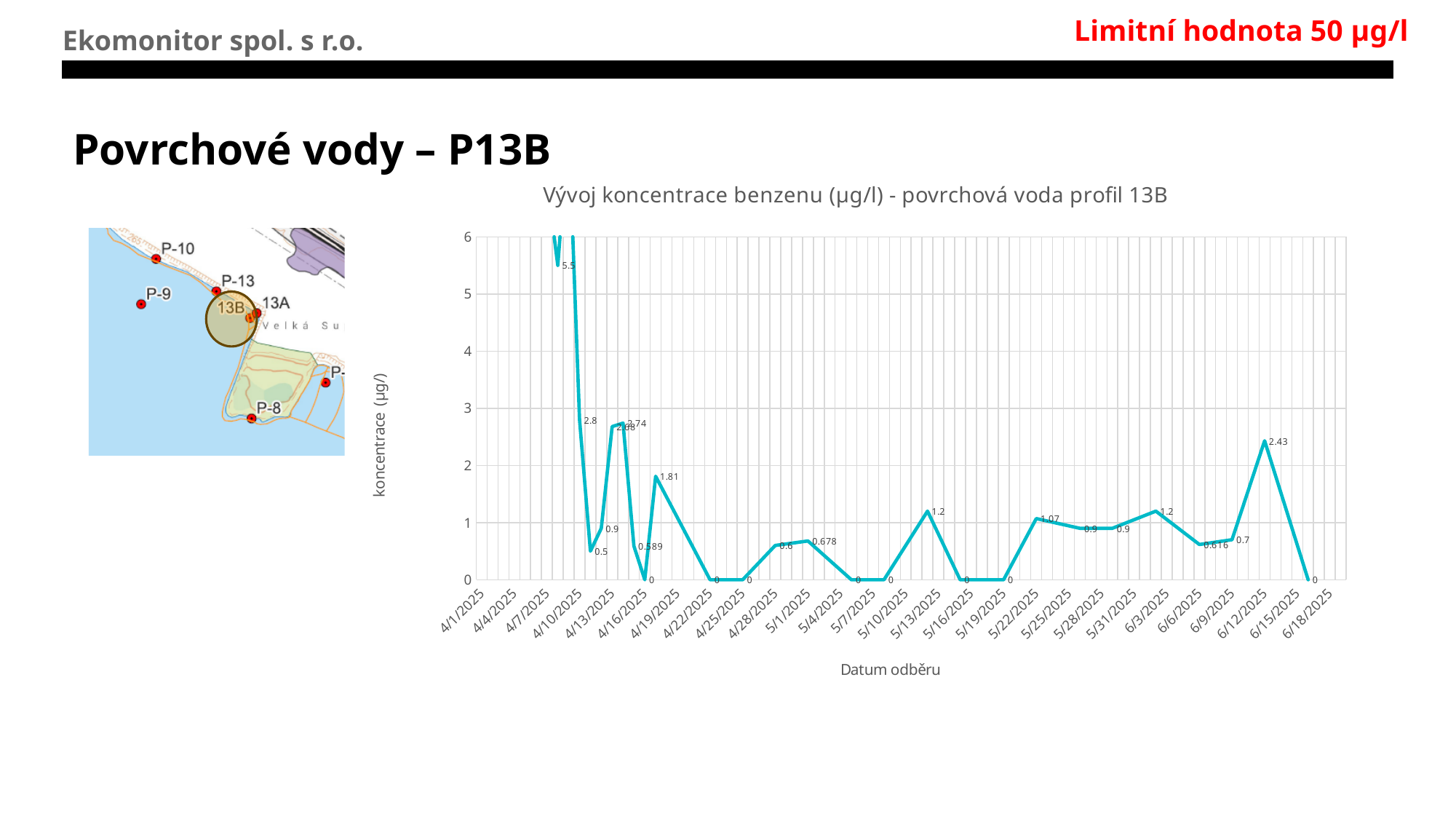
Which date has the larger plotted value, 5/22/2025 or 6/6/2025? 5/22/2025 What kind of chart is shown on the slide? line chart Is the value plotted for 6/12/2025 greater or less than 2? greater What is the benzene concentration plotted for 6/12/2025? 2.43 What is the benzene concentration plotted for 5/22/2025? 1.07 What is the title of the x axis of the chart? Datum odběru What is the title of the y axis of the chart? koncentrace (µg/l)